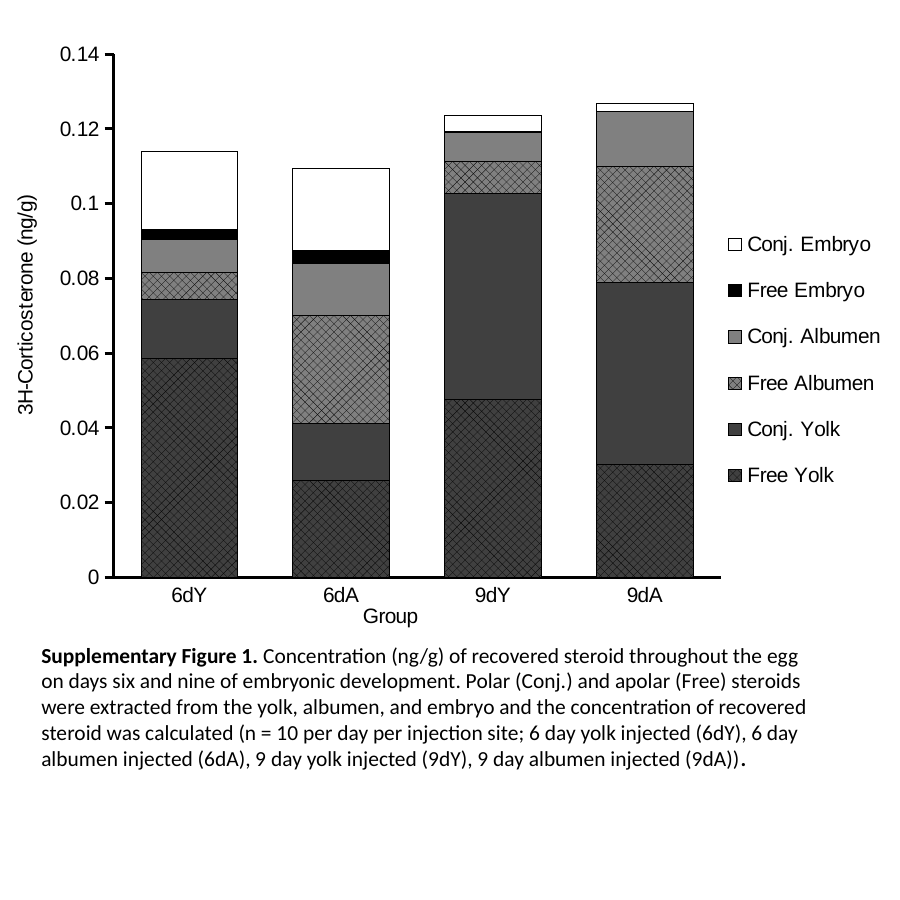
What kind of chart is shown on the slide? Stacked bar chart Is the total stacked value for 6dY greater or less than 0.1? greater Is the Free Yolk value for 6dA greater or less than 0.04? less Is the total stacked value for 9dA greater or less than 0.12? greater Which group has the largest Free Albumen segment? 9dA Which group has the largest Free Yolk segment? 6dY How many groups are shown on the x axis of the chart? 4 How many series does the chart's legend list? 6 What is the label of the y axis of the chart? 3H-Corticosterone (ng/g) Which has the larger total stacked value, 9dY or 6dA? 9dY